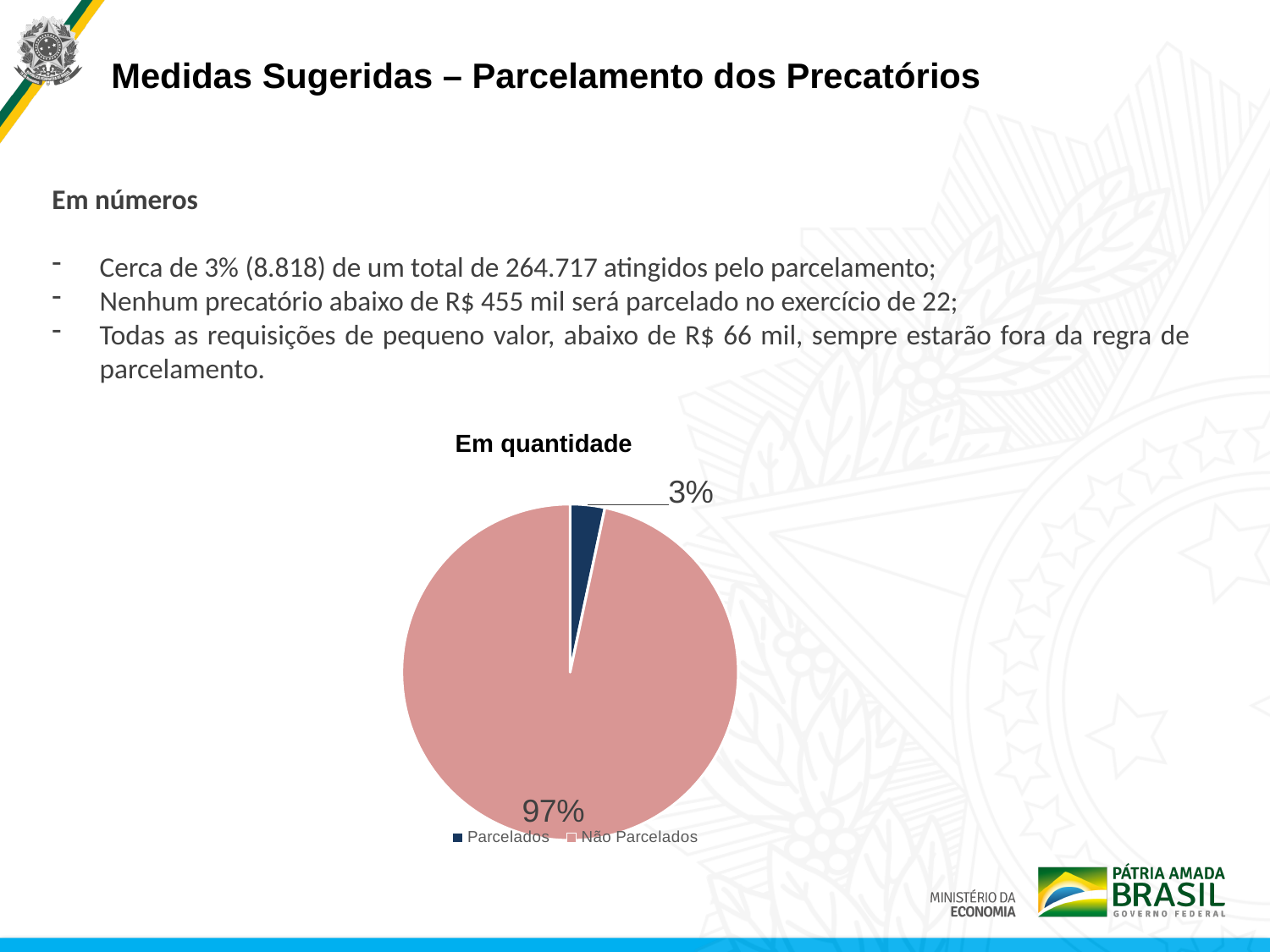
What is the difference in percentage points between the Não Parcelados and Parcelados slices? 94% How many entries does the legend list? 2 What is the title of the chart? Em quantidade How many slices does the pie chart have? 2 What kind of chart is shown on the slide? pie chart What share of the pie is labelled Não Parcelados? 97% What share of the pie is labelled Parcelados? 3% Which slice of the pie is the largest? Não Parcelados What colour is the Parcelados slice in the pie chart? dark blue Which slice of the pie is the smallest? Parcelados Which is larger, the Parcelados slice or the Não Parcelados slice? Não Parcelados